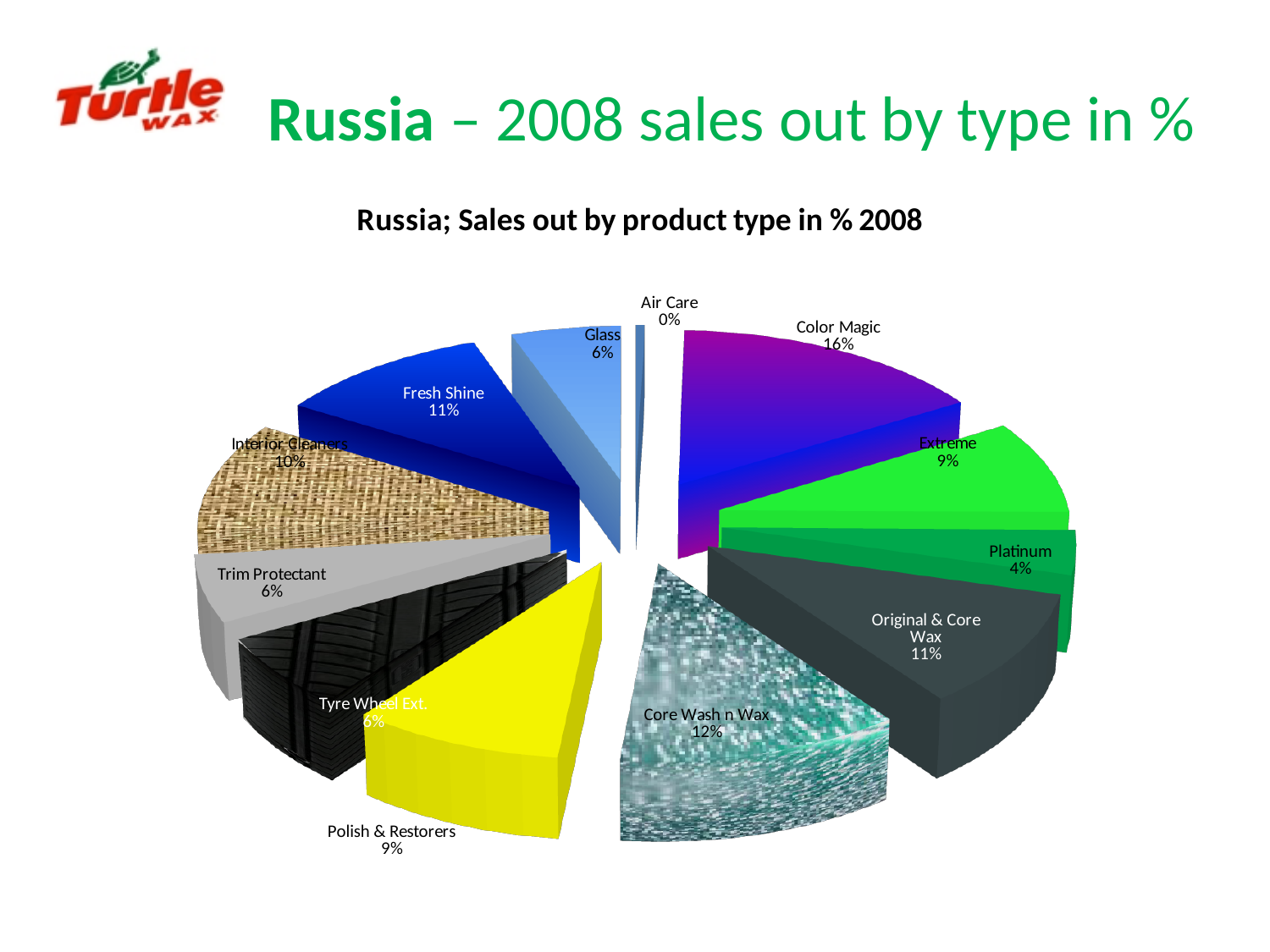
What is the combined share of Glass and Polish & Restorers? 15% Which product type has the largest share of sales? Color Magic What is the chart's title? Russia; Sales out by product type in % 2008 What share of sales does Color Magic account for? 16% What percentage is shown for Platinum? 4% Which product type has the smallest share of sales? Air Care How many product types are shown in the pie chart? 12 What is the value for Interior Cleaners? 10% What is the difference between the shares of Color Magic and Extreme? 7% What is the value shown for Core Wash n Wax? 12% Which has a larger share, Fresh Shine or Trim Protectant? Fresh Shine What type of chart is shown on the slide? Pie chart